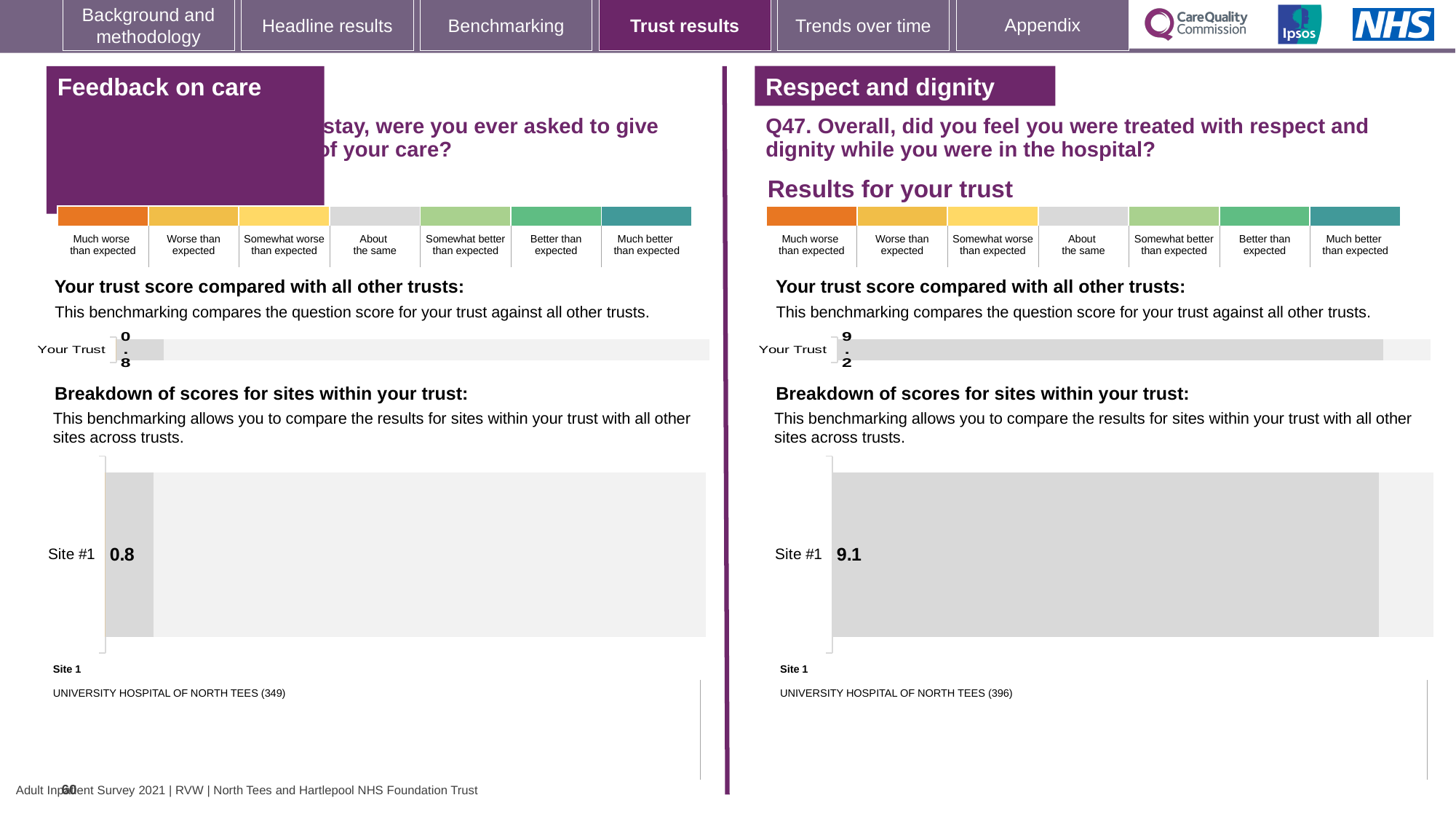
What is the difference between the Site #1 score in the 'Respect and dignity' breakdown chart and the Site #1 score in the 'Feedback on care' breakdown chart? 8.3 In the 'Feedback on care' section, which site name is listed as Site 1 below the breakdown chart? UNIVERSITY HOSPITAL OF NORTH TEES (349) Which has the higher Site #1 score: the 'Feedback on care' breakdown chart or the 'Respect and dignity' breakdown chart? Respect and dignity What is the difference between the Your Trust score in the 'Respect and dignity' section and the Your Trust score in the 'Feedback on care' section? 8.4 How many sites are shown in the 'Breakdown of scores for sites within your trust' chart in the 'Respect and dignity' section? 1 In the 'Respect and dignity' section, what score is shown for Site #1 in the 'Breakdown of scores for sites within your trust' chart? 9.1 In the 'Feedback on care' section, what score is shown for Site #1 in the 'Breakdown of scores for sites within your trust' chart? 0.8 What kind of chart is used to show the Site #1 score in the 'Feedback on care' breakdown section? Bar chart In the 'Respect and dignity' section, which site name is listed as Site 1 below the breakdown chart? UNIVERSITY HOSPITAL OF NORTH TEES (396) In the 'Respect and dignity' section, what is the difference between the Your Trust score and the Site #1 score? 0.1 In the 'Feedback on care' section, what is the score shown for Your Trust in the 'Your trust score compared with all other trusts' chart? 0.8 In the 'Respect and dignity' section, what is the score shown for Your Trust in the 'Your trust score compared with all other trusts' chart? 9.2